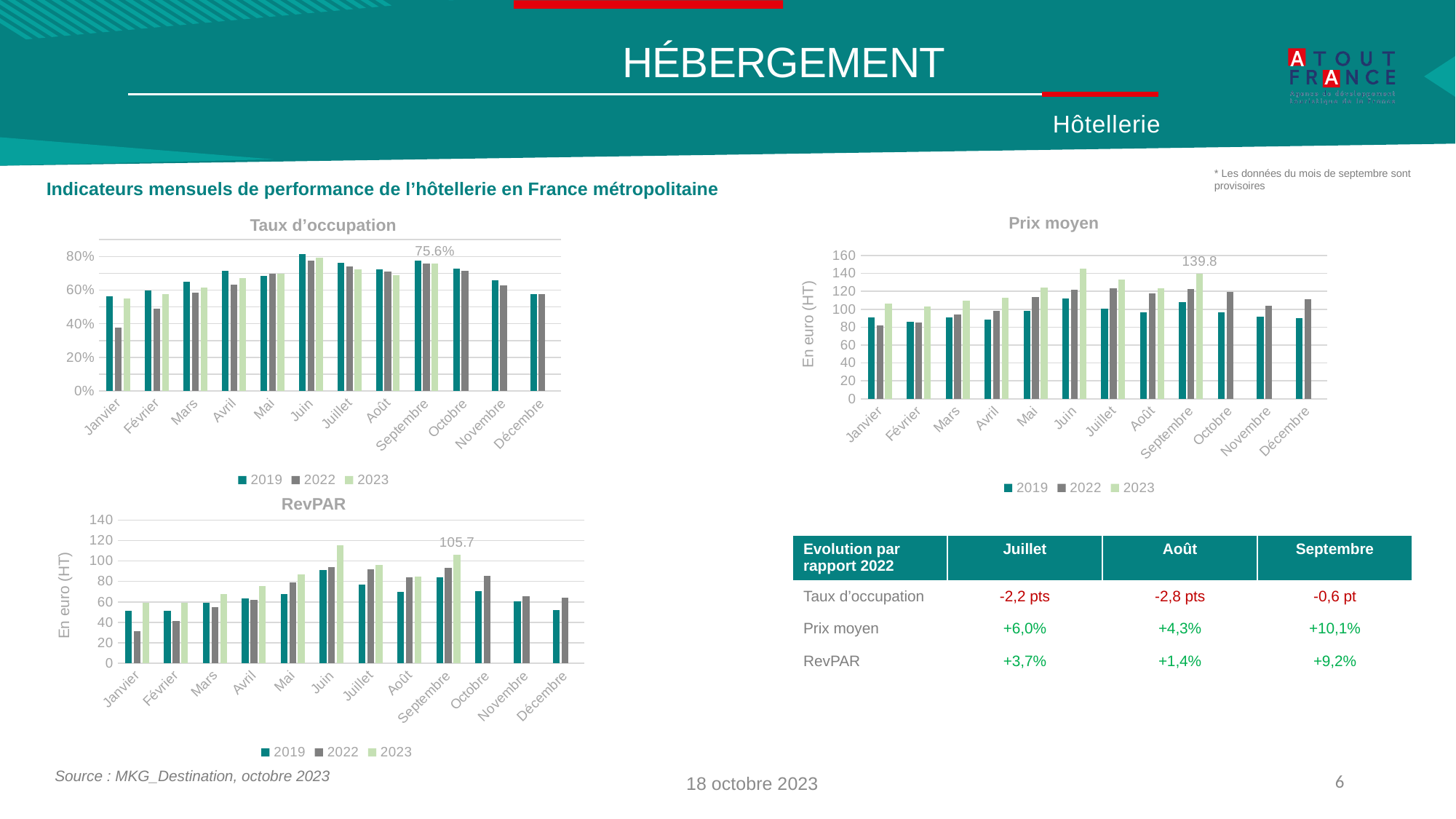
In the Taux d'occupation chart, is the 2022 value for Janvier greater or less than 60%? less What is the y-axis label of the Prix moyen chart? En euro (HT) In the Taux d'occupation chart, what is the labelled value for Septembre 2023? 75.6% How many series does the legend of the Taux d'occupation chart list? 3 In the Prix moyen chart, what is the labelled value for Septembre 2023? 139.8 In the RevPAR chart, which month has the highest 2023 value? Juin In the Prix moyen chart, which month has the highest 2023 value? Juin In the Prix moyen chart, is the 2023 value for Juin greater or less than 120? greater In the RevPAR chart, what is the labelled value for Septembre 2023? 105.7 What kind of chart is the RevPAR chart? Bar chart How many months are shown on the x axis of the Prix moyen chart? 12 In the Taux d'occupation chart, which is larger for Janvier: the 2019 value or the 2022 value? 2019